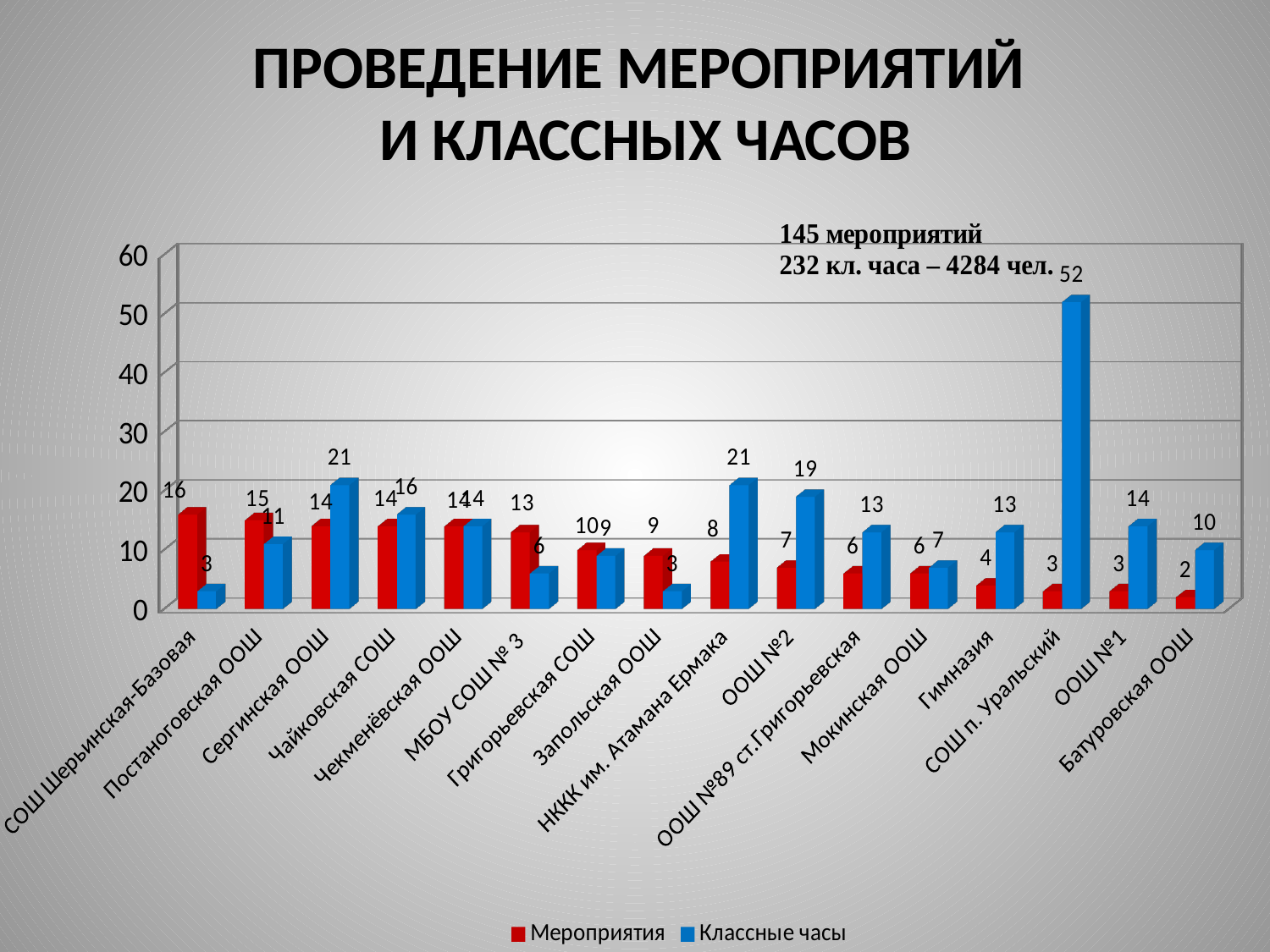
Which school has the highest value for Классные часы? СОШ п. Уральский Which school has the lowest value for Мероприятия? Батуровская ООШ What is the value of Классные часы for ООШ №2? 19 For Постаноговская ООШ, which is larger: Мероприятия or Классные часы? Мероприятия How many series does the legend list? 2 What is the value of Классные часы for СОШ п. Уральский? 52 What is the difference between Классные часы and Мероприятия for НККК им. Атамана Ермака? 13 Which series is shown in red in the legend? Мероприятия What type of chart is shown on the slide? Bar chart What is the value of Мероприятия for СОШ Шерьинская-Базовая? 16 What total number of мероприятий is stated in the text annotation on the chart? 145 мероприятий How many schools (categories) are shown on the x axis? 16